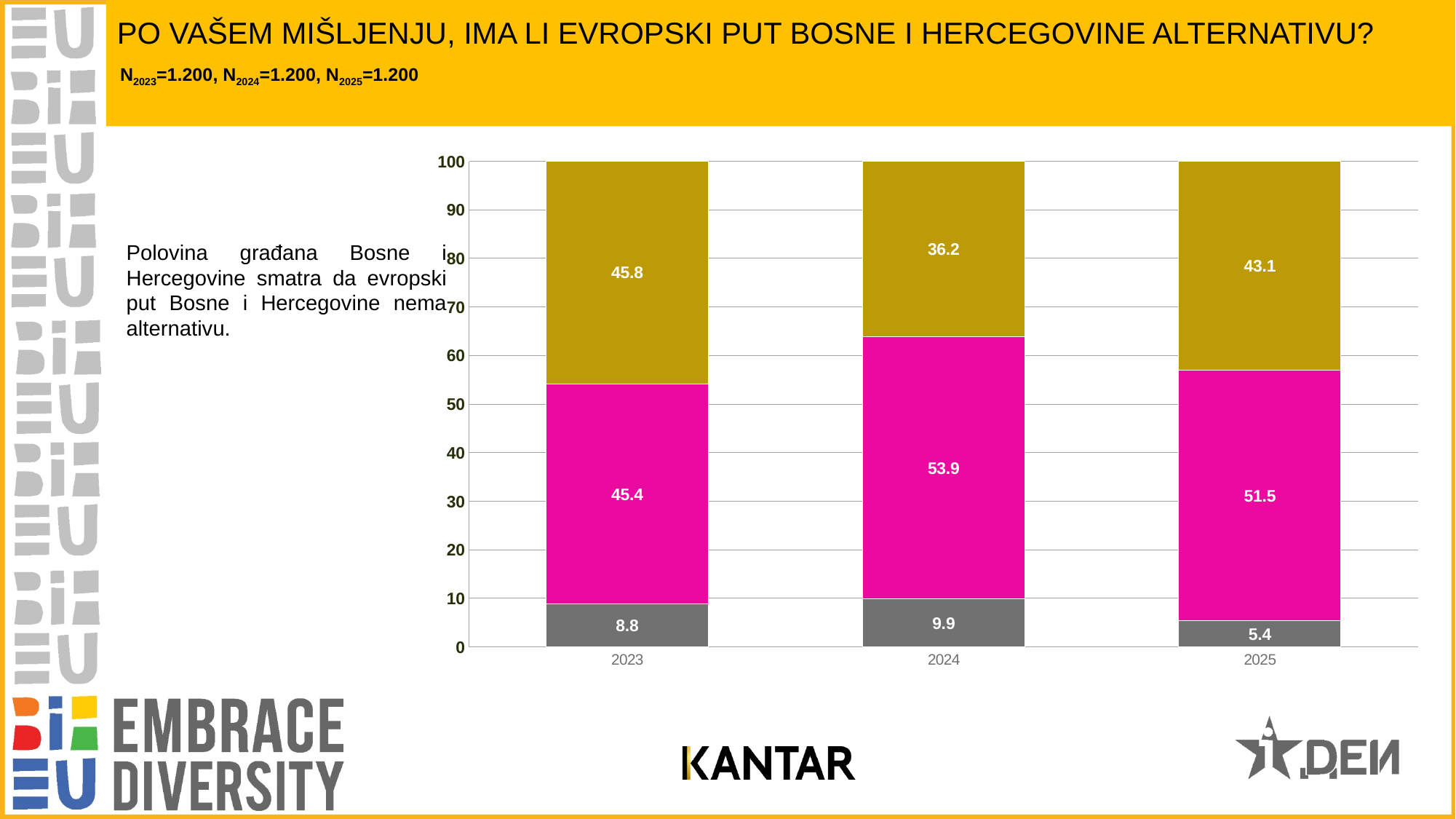
What is the total of the stacked bar for 2024? 100.0 In which year is the magenta segment the largest? 2024 What is the value of the grey (bottom) segment for 2023? 8.8 How many years (categories) are shown on the x axis of the chart? 3 How does the grey (bottom) segment change from 2024 to 2025? it falls In which year is the grey (bottom) segment the smallest? 2025 What is the value of the magenta segment for 2024? 53.9 What is the difference between the magenta segment values for 2024 and 2023? 8.5 What is the value of the gold (top) segment for 2025? 43.1 What kind of chart is shown on the slide? stacked bar chart Which is larger in 2025: the magenta segment or the gold segment? the magenta segment In which year is the gold (top) segment the smallest? 2024